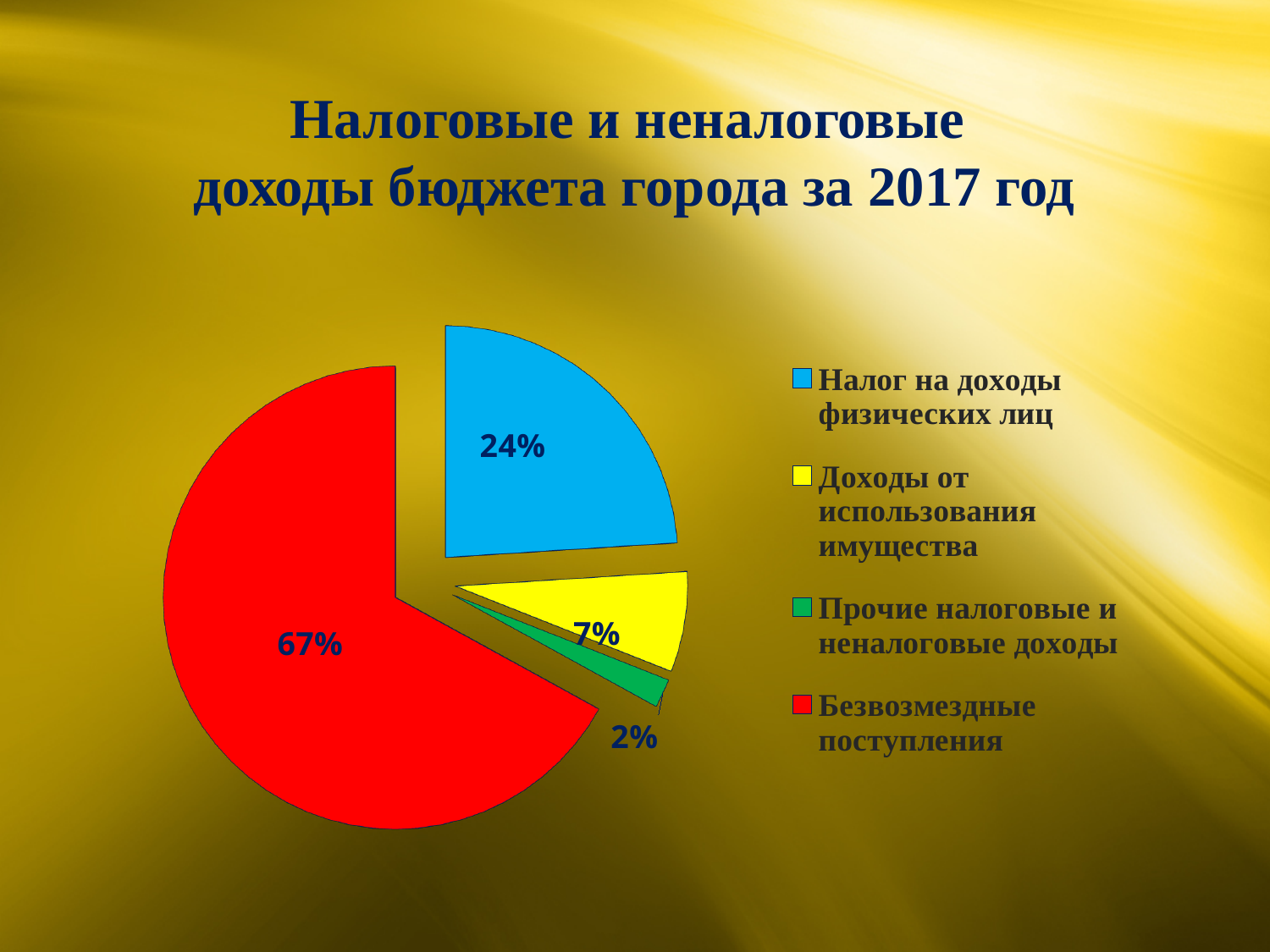
Which is larger: Доходы от использования имущества or Прочие налоговые и неналоговые доходы? Доходы от использования имущества How many slices does the pie chart have? 4 What is the difference in percentage points between Безвозмездные поступления and Налог на доходы физических лиц? 43 What percentage is shown for Доходы от использования имущества? 7% What share of the pie does Безвозмездные поступления account for? 67% Which category has the smallest slice of the pie? Прочие налоговые и неналоговые доходы Which category has the largest slice of the pie? Безвозмездные поступления What percentage is shown for Налог на доходы физических лиц? 24% What colour is the slice for Налог на доходы физических лиц? Blue What kind of chart is shown on the slide? Pie chart What percentage is shown for Прочие налоговые и неналоговые доходы? 2% What is the title of the slide? Налоговые и неналоговые доходы бюджета города за 2017 год